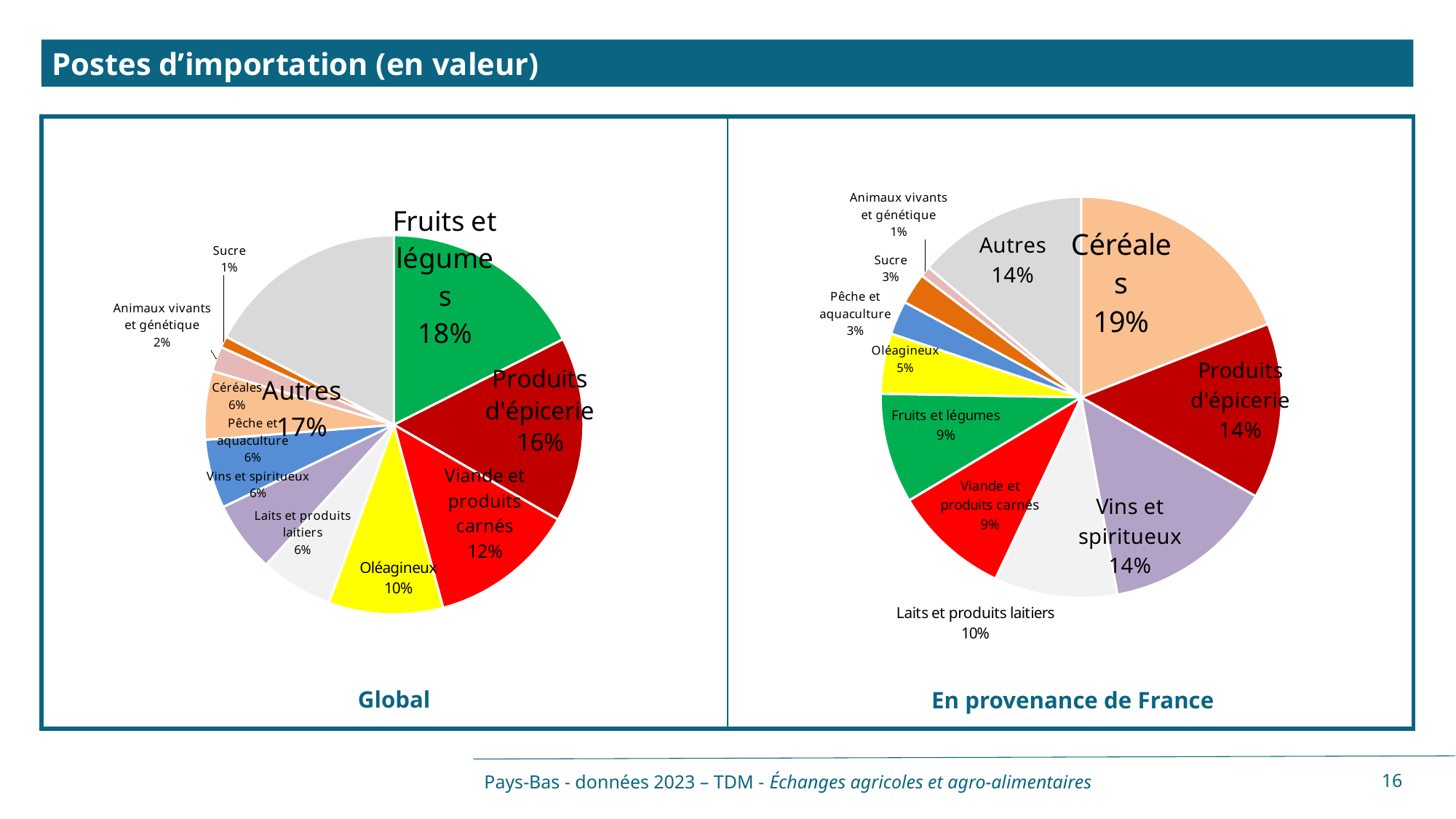
In the 'Global' chart, what share do Fruits et légumes represent? 18% In the 'En provenance de France' chart, what share do Laits et produits laitiers represent? 10% In the 'Global' chart, which named product category (excluding Autres) has the largest share? Fruits et légumes What is the title of the slide? Postes d'importation (en valeur) In the 'Global' chart, what share do Oléagineux represent? 10% In the 'En provenance de France' chart, what is the difference between the shares of Céréales and Oléagineux? 14 percentage points How many slices does the 'Global' pie chart have? 11 In the 'En provenance de France' chart, what share do Céréales represent? 19% Which is larger in the 'En provenance de France' chart: the share of Vins et spiritueux or the share of Fruits et légumes? Vins et spiritueux In the 'En provenance de France' chart, which category has the smallest share? Animaux vivants et génétique In the 'Global' chart, what is the difference between the shares of Produits d'épicerie and Viande et produits carnés? 4 percentage points What type of chart is used on this slide? Pie chart